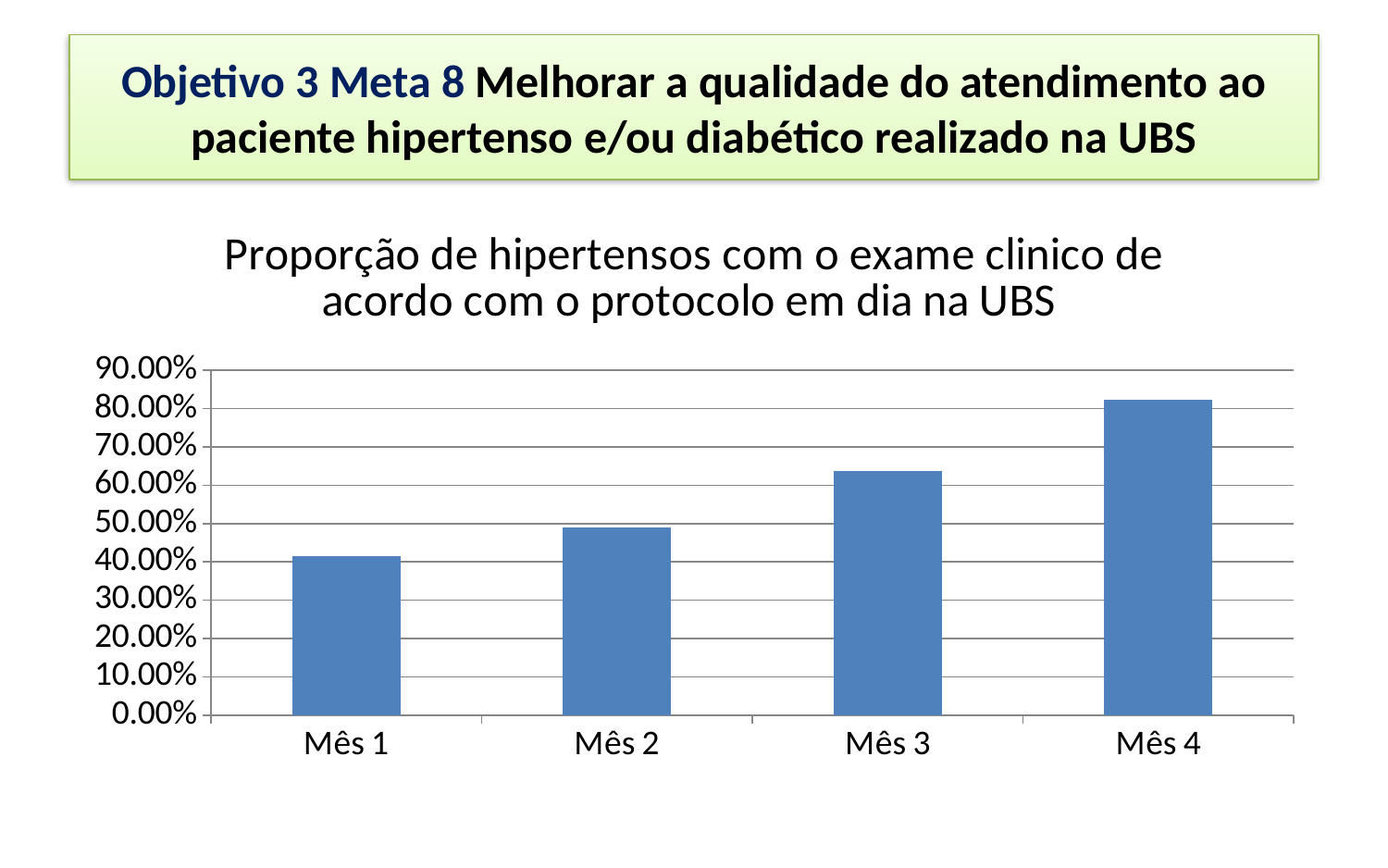
How many months (categories) are plotted on the chart? 4 Is the value for Mês 3 greater or less than 60.00%? greater Which is larger, the value for Mês 2 or the value for Mês 3? Mês 3 What is the title of the chart? Proporção de hipertensos com o exame clinico de acordo com o protocolo em dia na UBS Is the value for Mês 4 greater or less than 70.00%? greater Which month has the highest proportion of hypertensive patients with clinical exam up to date? Mês 4 Which month has the lowest proportion of hypertensive patients with clinical exam up to date? Mês 1 What is the highest value shown on the vertical axis? 90.00% Do the values rise or fall from Mês 1 to Mês 4? rise Is the value for Mês 2 greater or less than 40.00%? greater What kind of chart is shown on the slide? bar chart